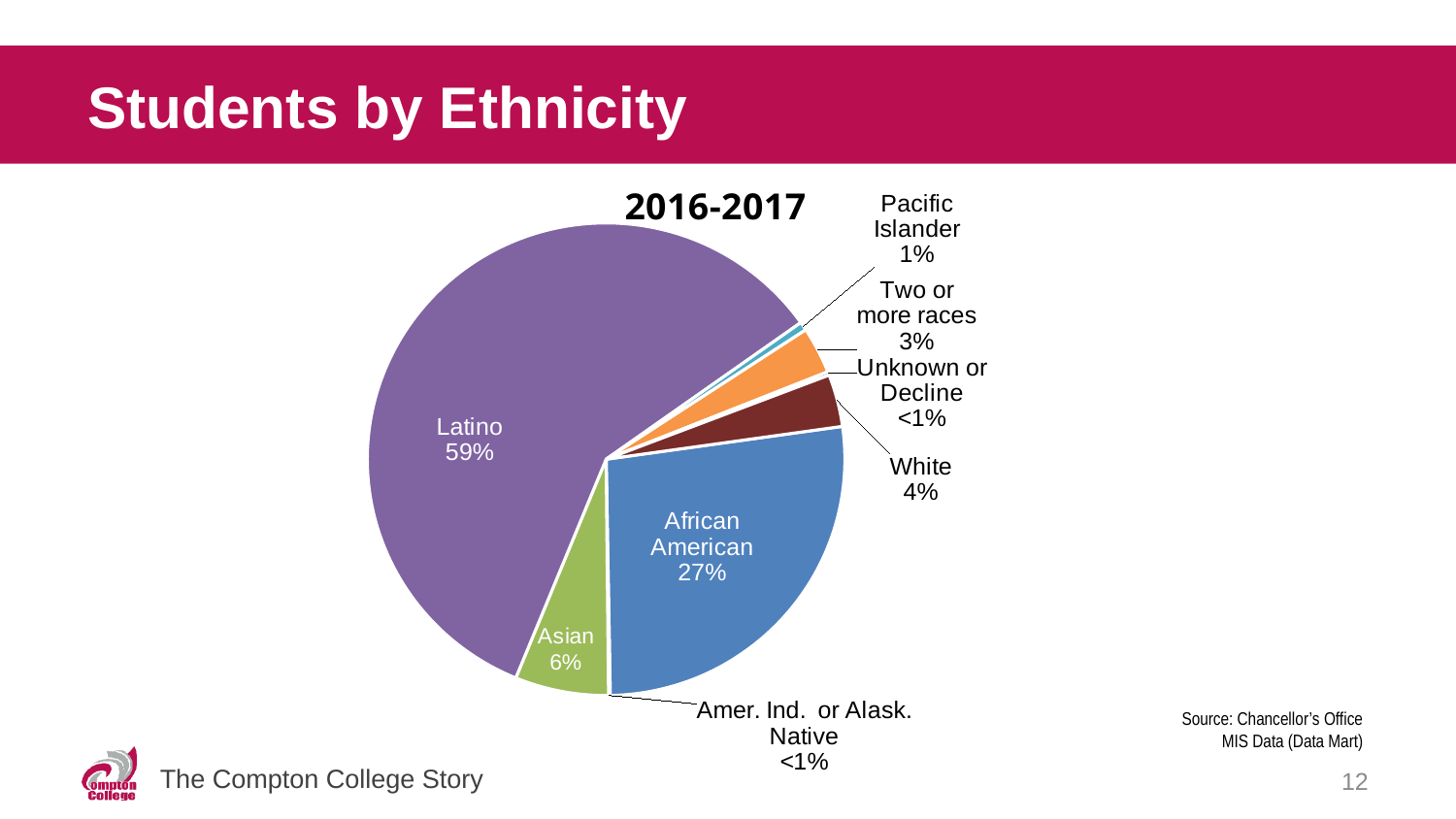
What is the title shown above the pie chart? 2016-2017 How many ethnicity categories are shown in the pie chart? 8 What type of chart is shown on the slide? Pie chart Which ethnicity has the largest share of students? Latino Which is larger, the share of Asian students or the share of White students? Asian What percentage of students are Pacific Islander? 1% What percentage of students are African American? 27% What percentage of students are White? 4% What share of students are Asian? 6% What share of students are Latino? 59% What share of students are Two or more races? 3% What is the difference in percentage points between the Latino and African American shares? 32